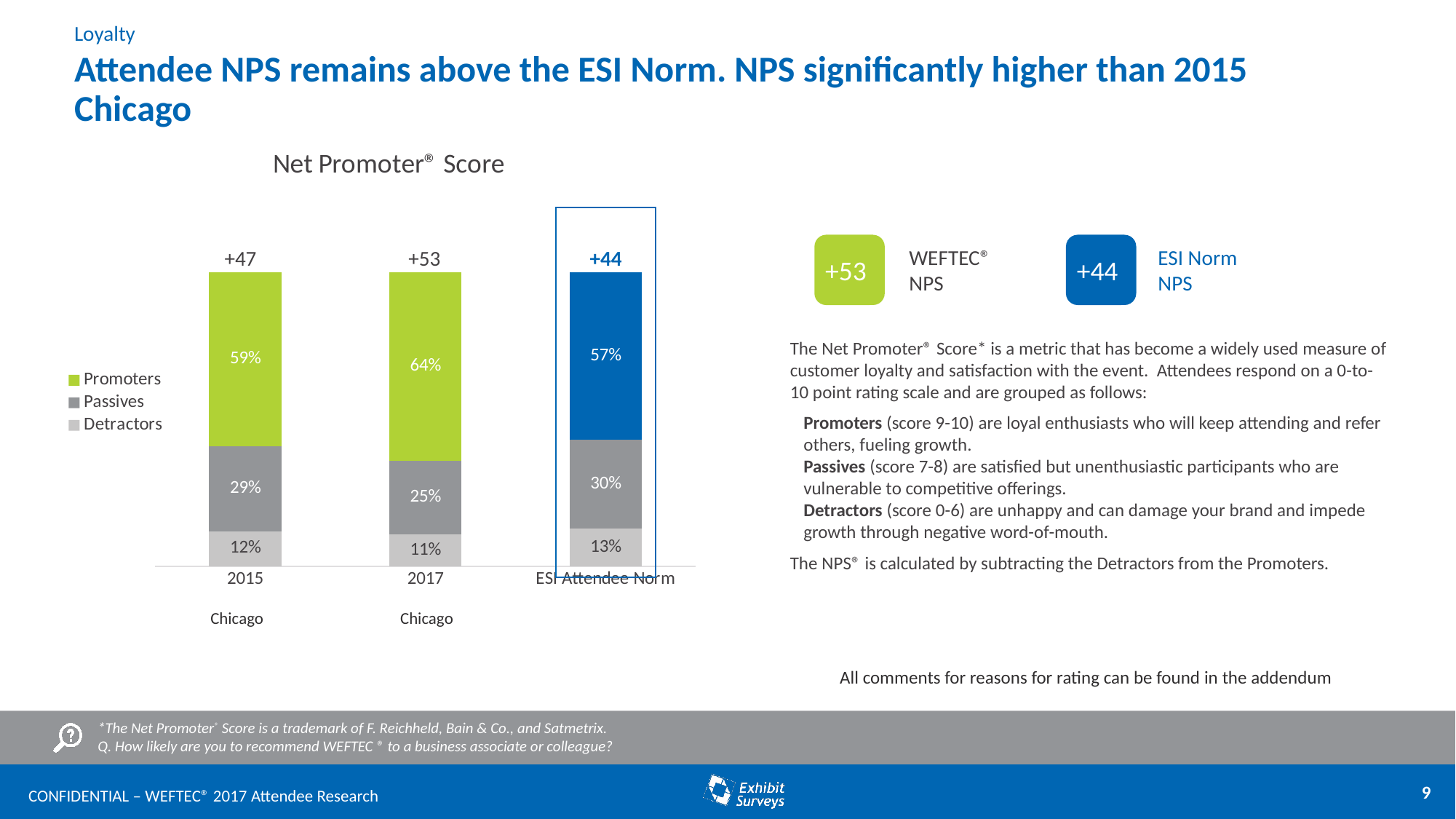
Which colour represents Promoters in the chart legend? Green What is the difference between the Promoters percentage for 2017 Chicago and 2015 Chicago? 5% Which category has the highest Promoters percentage? 2017 Chicago What percentage of 2017 Chicago attendees are Promoters? 64% How many categories are shown on the x axis of the chart? 3 What is the Net Promoter Score shown above the 2017 Chicago bar? +53 Which category has the lowest Detractors percentage? 2017 Chicago What kind of chart is shown on the slide? Stacked bar chart How many series does the chart legend list? 3 What is the Passives percentage for 2015 Chicago? 29% Which is larger, the Passives percentage for the ESI Attendee Norm or for 2017 Chicago? ESI Attendee Norm What is the Detractors percentage for the ESI Attendee Norm? 13%